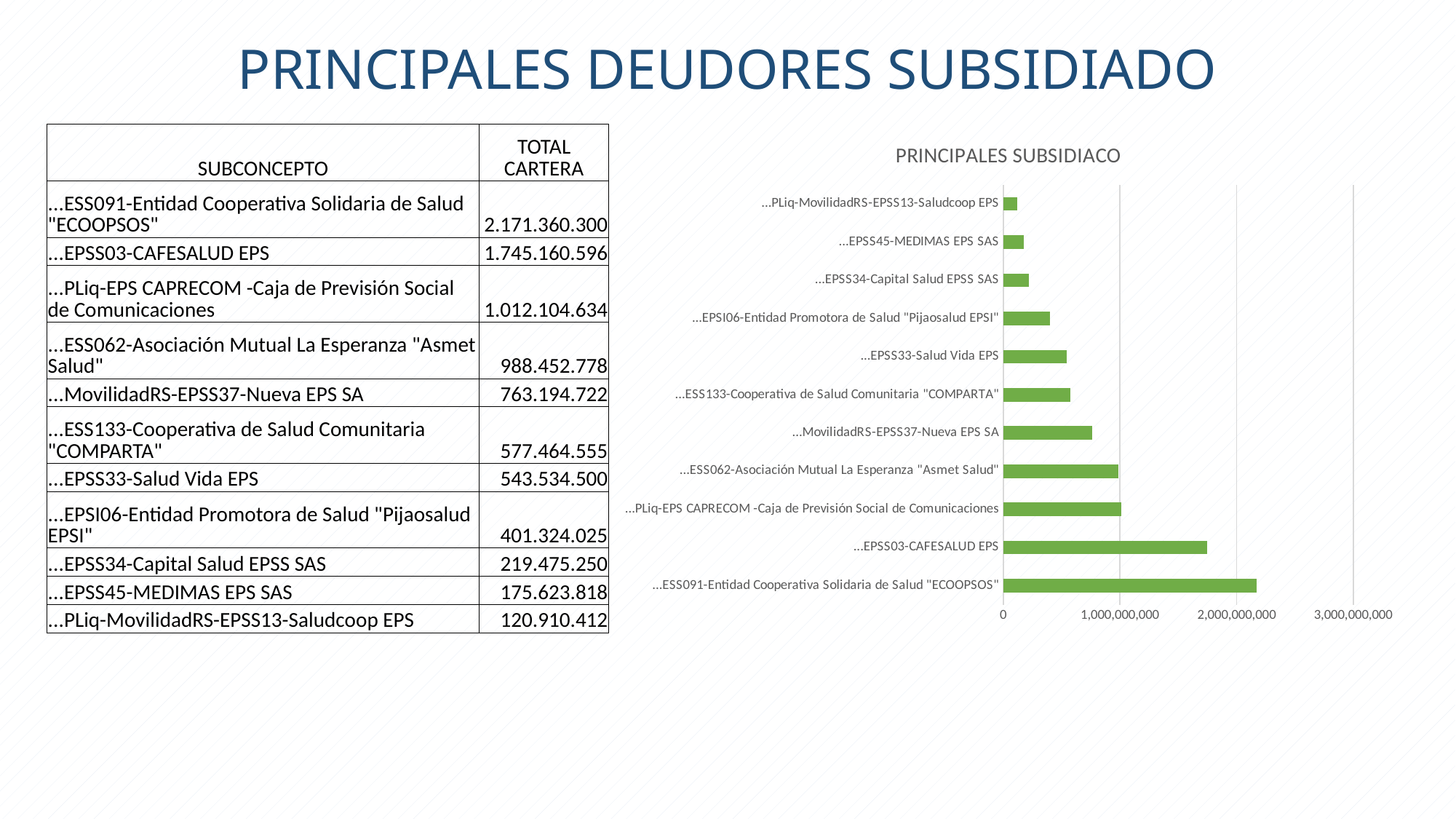
Is the value for ...EPSS03-CAFESALUD EPS greater or less than 2,000,000,000? less Is the value for ...MovilidadRS-EPSS37-Nueva EPS SA greater or less than 1,000,000,000? less Is the value for ...EPSS33-Salud Vida EPS greater or less than 1,000,000,000? less Which category has the shortest bar in the chart? ...PLiq-MovilidadRS-EPSS13-Saludcoop EPS Which is larger: the value for ...EPSS03-CAFESALUD EPS or the value for ...PLiq-EPS CAPRECOM -Caja de Previsión Social de Comunicaciones? ...EPSS03-CAFESALUD EPS What colour are the bars in the chart? green Which category has the longest bar in the chart? ...ESS091-Entidad Cooperativa Solidaria de Salud "ECOOPSOS" How many categories (bars) does the chart show? 11 What is the title of the chart? PRINCIPALES SUBSIDIACO What kind of chart is shown on the slide? bar chart Which is larger: the value for ...ESS062-Asociación Mutual La Esperanza "Asmet Salud" or the value for ...ESS133-Cooperativa de Salud Comunitaria "COMPARTA"? ...ESS062-Asociación Mutual La Esperanza "Asmet Salud"